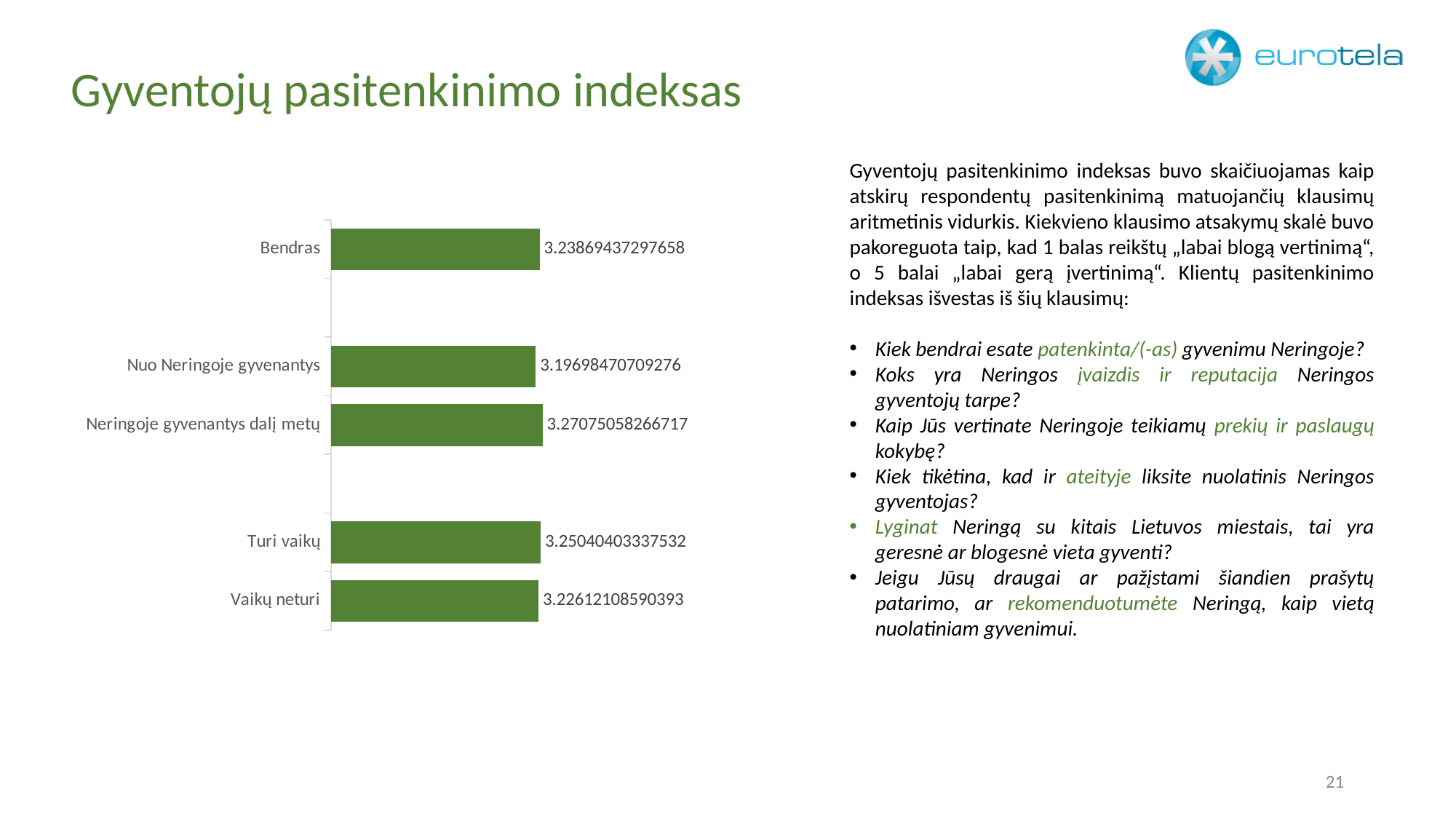
What is the difference between the values for Neringoje gyvenantys dalį metų and Nuo Neringoje gyvenantys? 0.07376587557441 Which category has the highest value? Neringoje gyvenantys dalį metų What is the value for Bendras? 3.23869437297658 What kind of chart is shown on the slide? Bar chart How many categories are shown in the chart? 5 What is the value for Vaikų neturi? 3.22612108590393 Which is larger, the value for Turi vaikų or the value for Vaikų neturi? Turi vaikų Which category has the lowest value? Nuo Neringoje gyvenantys What is the difference between the values for Turi vaikų and Vaikų neturi? 0.02428294747139 What is the value for Nuo Neringoje gyvenantys? 3.19698470709276 What is the value for Neringoje gyvenantys dalį metų? 3.27075058266717 What is the value for Turi vaikų? 3.25040403337532